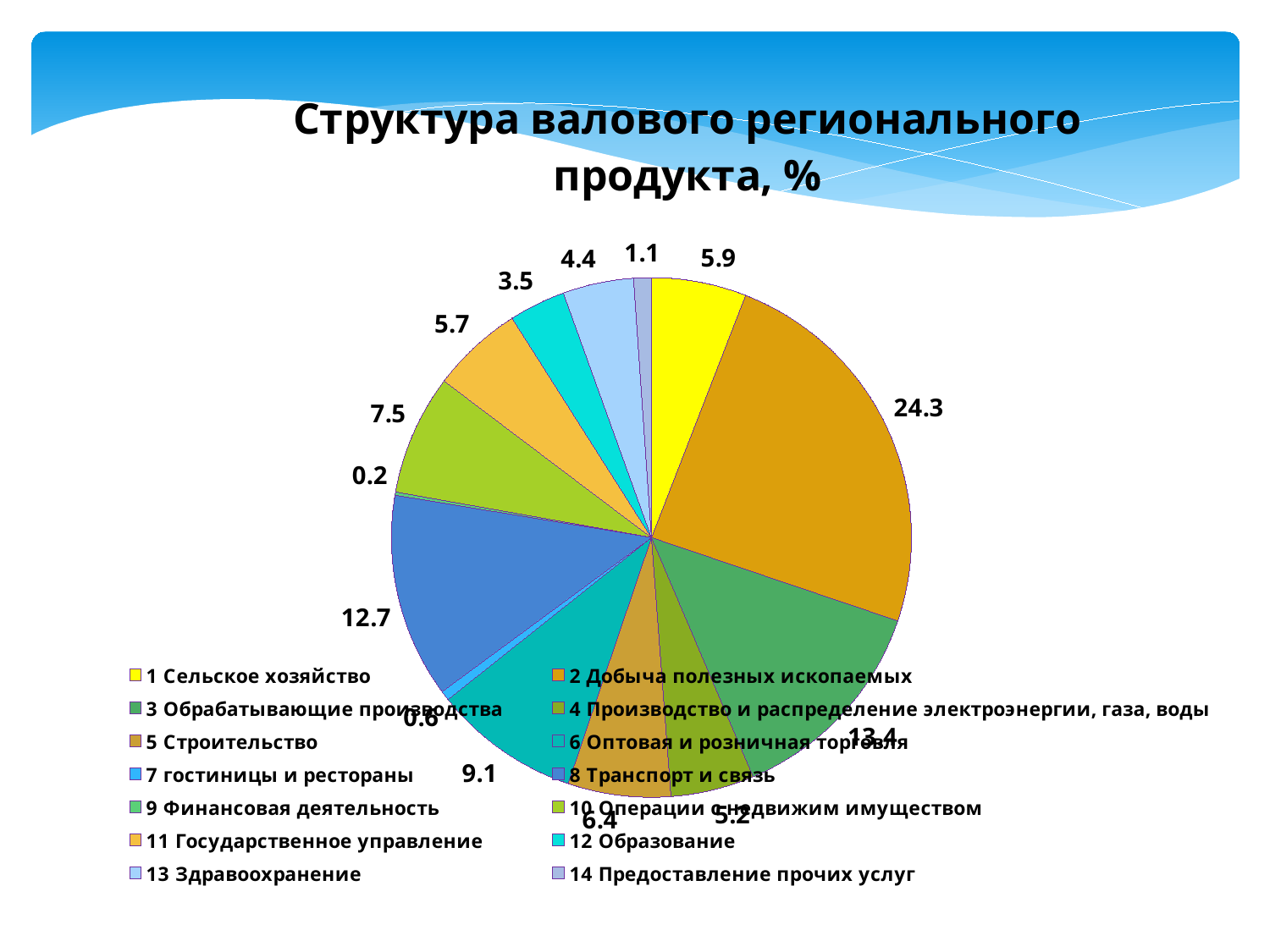
What type of chart is shown on the slide? pie chart What is the title of the chart? Структура валового регионального продукта, % What is the value for 8 Транспорт и связь? 12.7 How many categories does the legend list? 14 What is the value for 2 Добыча полезных ископаемых? 24.3 What is the difference between the values for 2 Добыча полезных ископаемых and 3 Обрабатывающие производства? 10.9 Which category has the largest share of the pie? 2 Добыча полезных ископаемых Which is larger, the value for 10 Операции с недвижимым имуществом or the value for 11 Государственное управление? 10 Операции с недвижимым имуществом What is the value for 13 Здравоохранение? 4.4 What colour is the slice for 1 Сельское хозяйство? yellow What is the value for 1 Сельское хозяйство? 5.9 Which category has the smallest share of the pie? 9 Финансовая деятельность